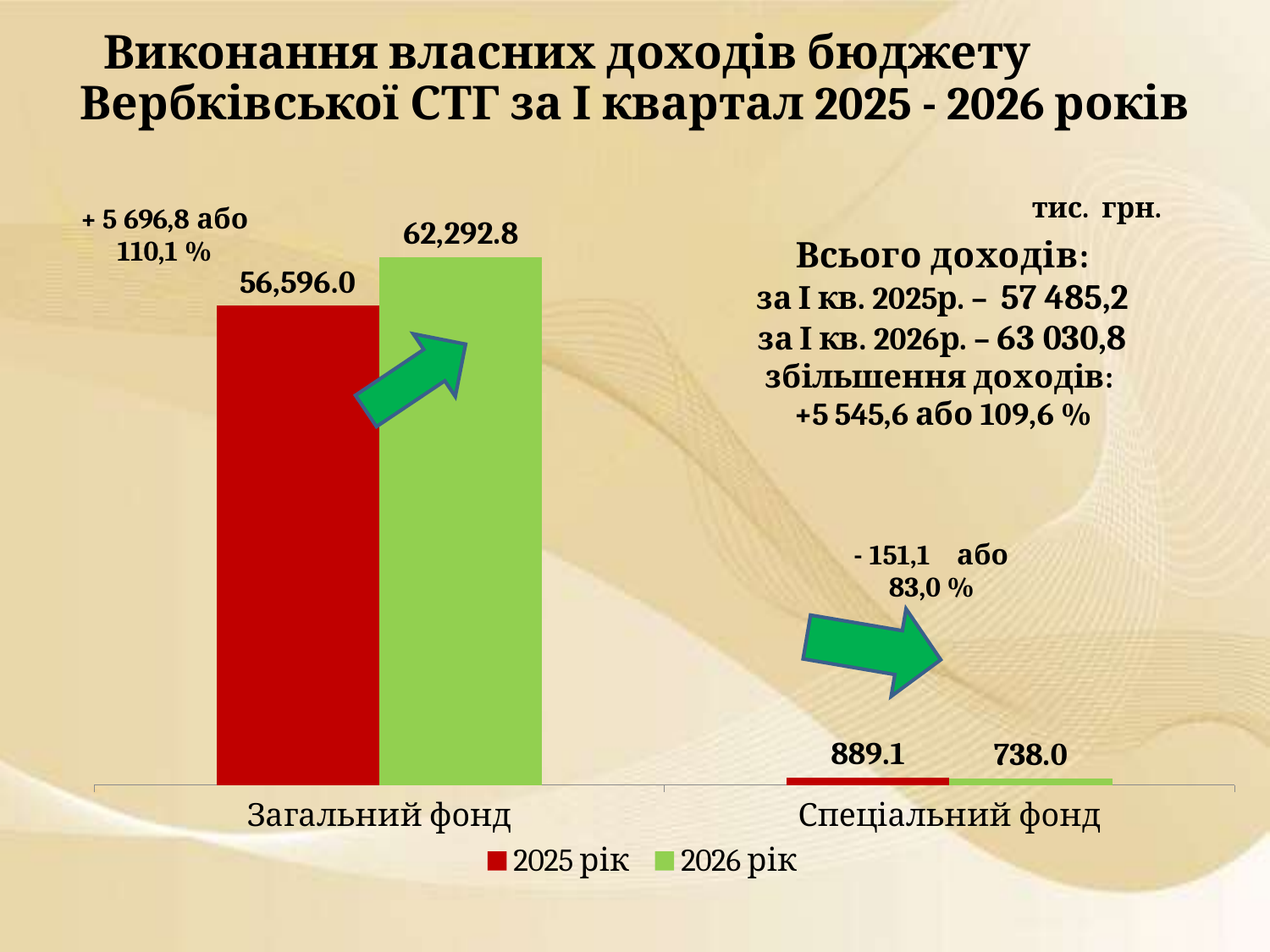
What kind of chart is shown on the slide? Bar chart What is the value for 2026 рік in the Загальний фонд category? 62,292.8 What is the difference between the 2025 рік and 2026 рік values for Спеціальний фонд? 151.1 Which bar has the highest value on the chart? 2026 рік, Загальний фонд How many series does the legend list? 2 What is the value for 2025 рік in the Спеціальний фонд category? 889.1 How many categories are shown on the x axis of the chart? 2 What is the difference between the 2026 рік and 2025 рік values for Загальний фонд? 5,696.8 For Спеціальний фонд, which is larger: the 2025 рік value or the 2026 рік value? 2025 рік What is the value for 2026 рік in the Спеціальний фонд category? 738.0 What is the value for 2025 рік in the Загальний фонд category? 56,596.0 Which bar has the lowest value on the chart? 2026 рік, Спеціальний фонд